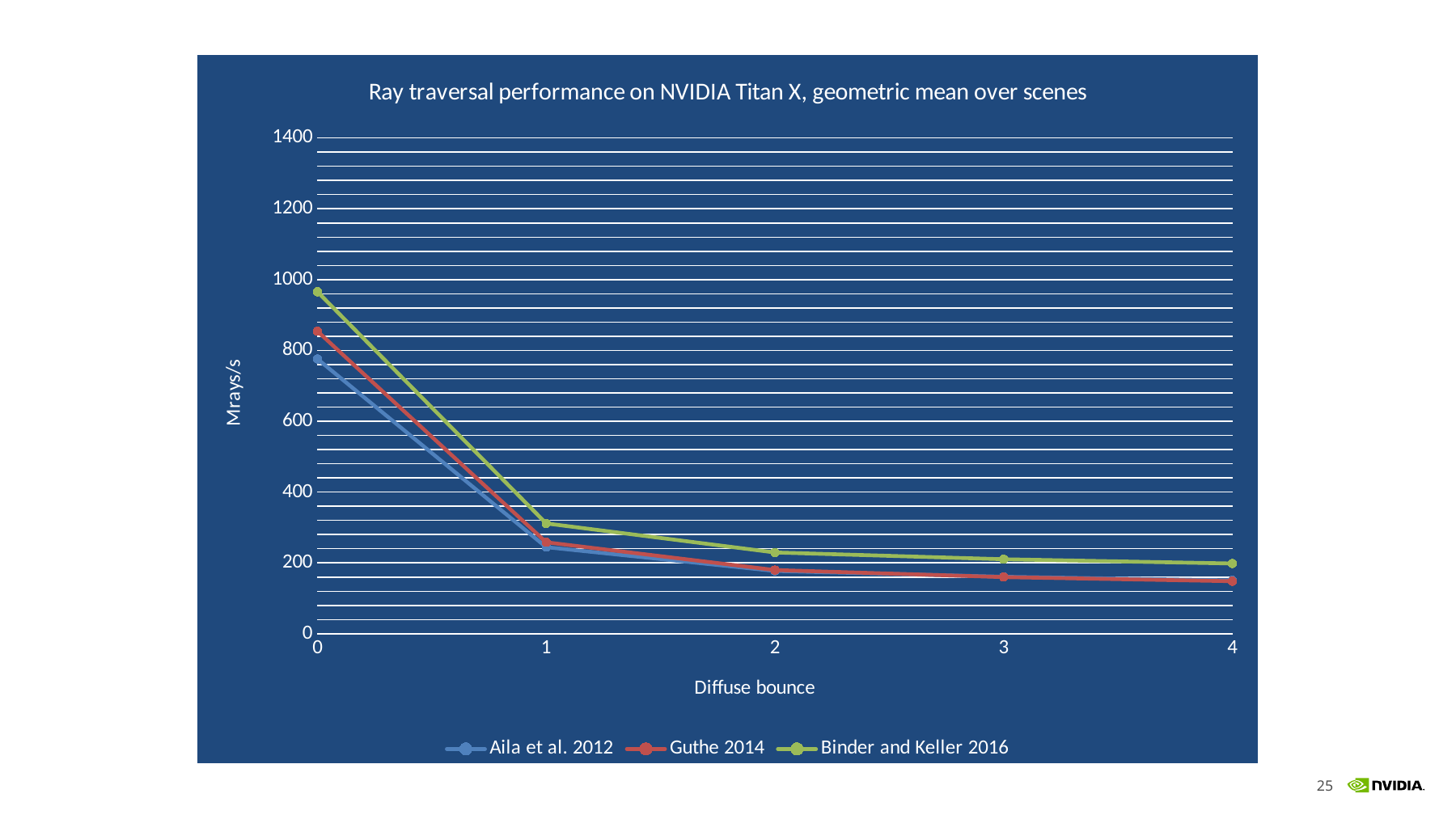
Is the value for Guthe 2014 at diffuse bounce 0 greater or less than 1000? less How many series does the legend list? 3 At diffuse bounce 0, which is larger: Guthe 2014 or Aila et al. 2012? Guthe 2014 Is the value for Binder and Keller 2016 at diffuse bounce 1 greater or less than 400? less Do the values for Binder and Keller 2016 rise or fall as the diffuse bounce increases from 0 to 4? fall Is the value for Guthe 2014 at diffuse bounce 4 greater or less than 200? less What is the label of the y axis? Mrays/s Which series has the lowest value at diffuse bounce 0? Aila et al. 2012 Which series has the highest value at diffuse bounce 0? Binder and Keller 2016 How many diffuse bounce values are plotted along the x axis? 5 What kind of chart is shown on the slide? line chart